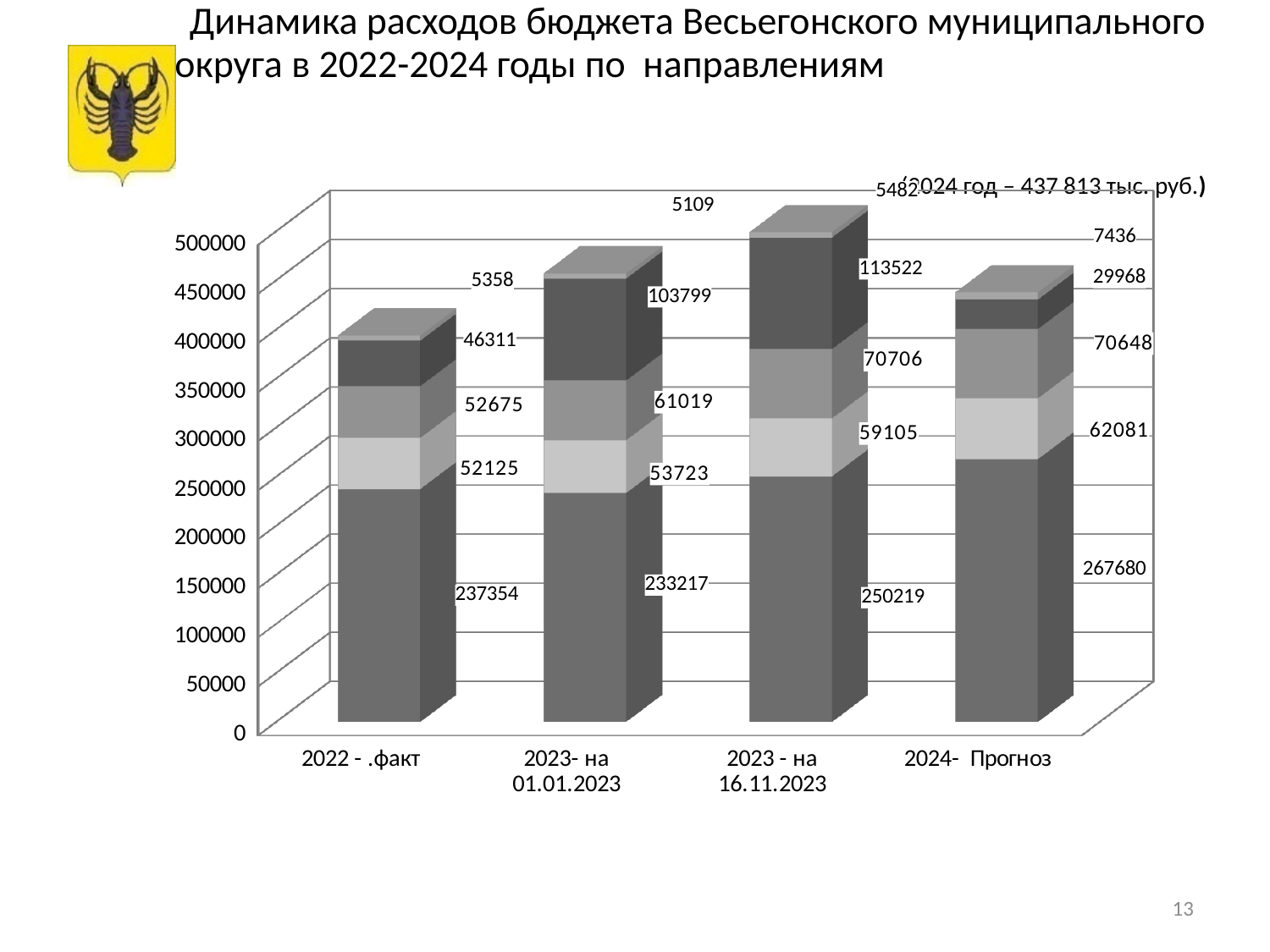
What total for 2024 is stated in the text annotation at the top right of the chart? 437 813 тыс. руб. What kind of chart is shown on the slide? stacked bar chart Which category has the highest value for the bottom segment of its bar? 2024- Прогноз What is the value of the bottom segment of the bar for "2024- Прогноз"? 267680 What is the total of the stacked bar for "2024- Прогноз"? 437813 What is the total of the stacked bar for "2022 - .факт"? 393823 Which is larger: the fourth segment from the bottom for "2023 - на 16.11.2023" (113522) or for "2024- Прогноз" (29968)? 2023 - на 16.11.2023 How many categories are shown along the x axis of the chart? 4 What is the value of the top segment of the bar for "2023 - на 16.11.2023"? 5482 What is the value of the bottom (largest) segment of the bar for "2022 - .факт"? 237354 What is the difference between the bottom segment values for "2024- Прогноз" and "2022 - .факт"? 30326 Which category has the lowest value for the bottom segment of its bar? 2023- на 01.01.2023